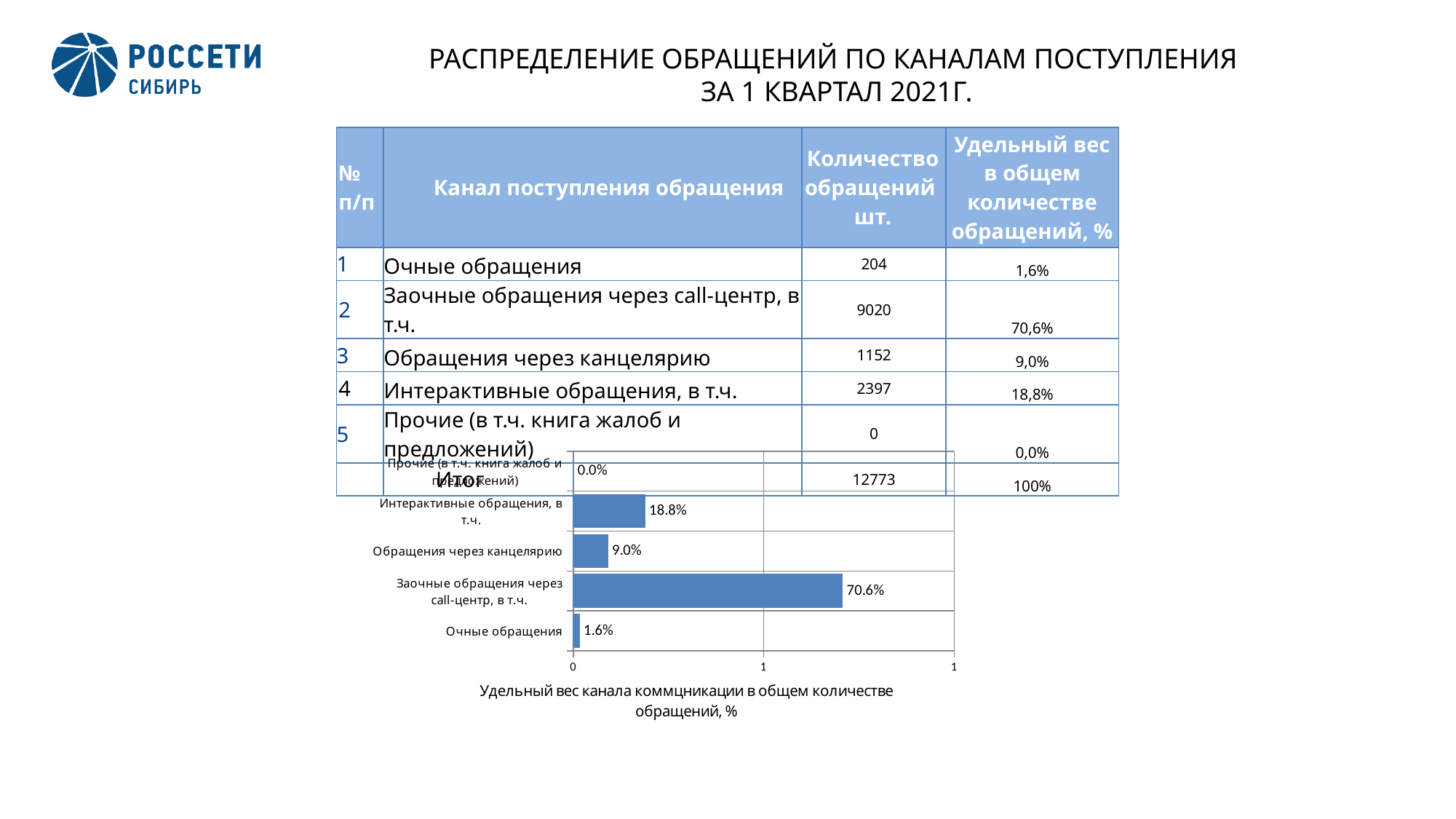
Which category has the highest value in the bar chart? Заочные обращения через call-центр, в т.ч. What type of chart is shown on the slide? bar chart How many categories are shown in the bar chart? 5 What is the value shown for "Очные обращения" in the bar chart? 1.6% Which category has the lowest value in the bar chart? Прочие (в т.ч. книга жалоб и предложений) What is the value shown for "Обращения через канцелярию" in the bar chart? 9.0% Which is larger in the bar chart: the value for "Обращения через канцелярию" or the value for "Очные обращения"? Обращения через канцелярию What is the value shown for "Интерактивные обращения, в т.ч." in the bar chart? 18.8% What is the value shown for "Прочие (в т.ч. книга жалоб и предложений)" in the bar chart? 0.0% What is the title text shown below the bar chart? Удельный вес канала коммцникации в общем количестве обращений, % What is the difference between the values for "Заочные обращения через call-центр, в т.ч." and "Интерактивные обращения, в т.ч." in the bar chart? 51.8% What is the value shown for "Заочные обращения через call-центр, в т.ч." in the bar chart? 70.6%